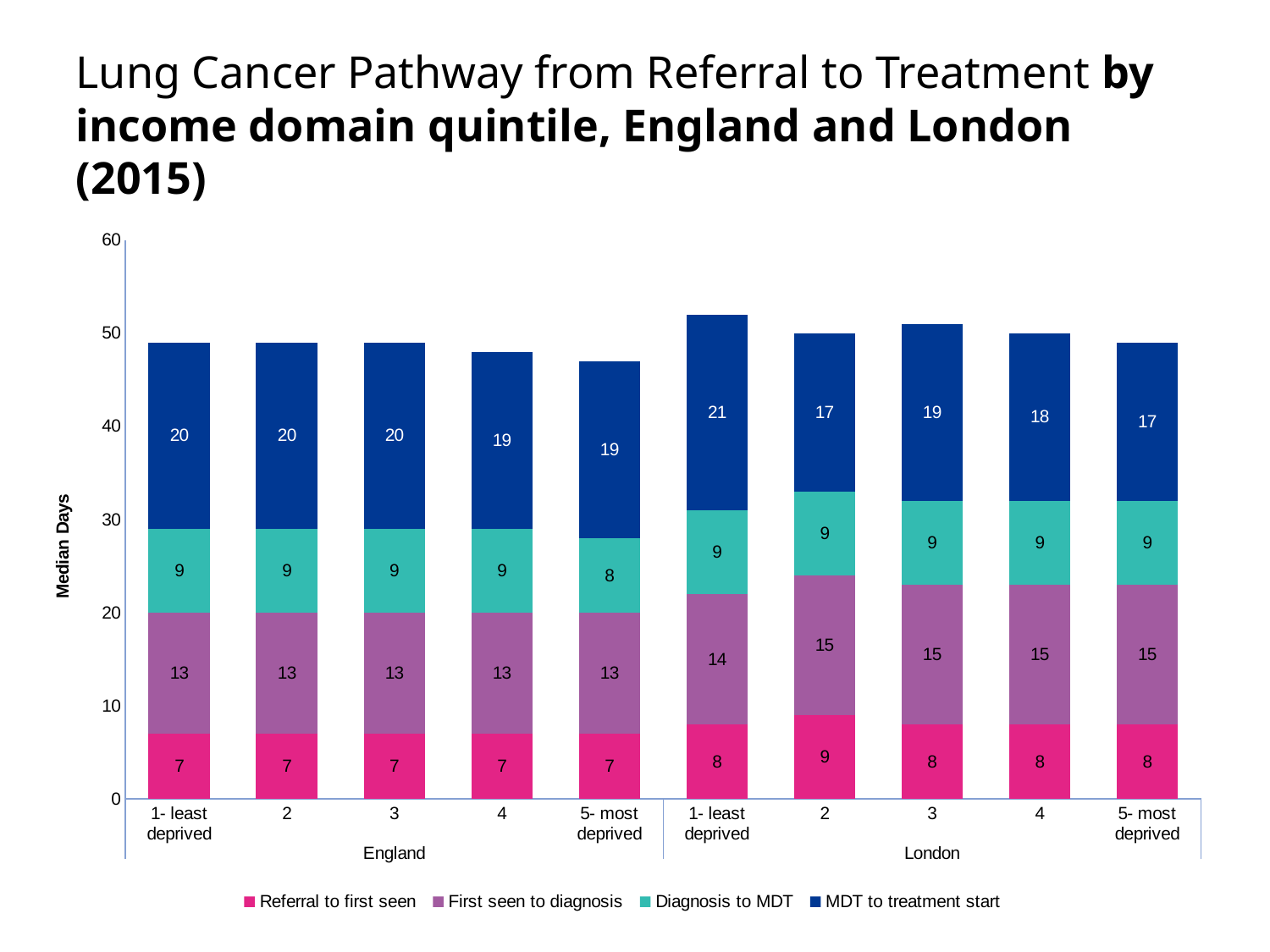
Which is larger: First seen to diagnosis for quintile 4 in England or for quintile 4 in London? Quintile 4 in London What is the total median days for the 1- least deprived quintile in London, summing all four stages? 52 Which bar has the lowest value for Diagnosis to MDT? 5- most deprived, England What is the median number of days from First seen to diagnosis for quintile 3 in England? 13 What is the difference in MDT to treatment start days between the 1- least deprived quintile in London and the 5- most deprived quintile in London? 4 What is the median number of days from Referral to first seen for quintile 2 in London? 9 Which bar has the highest value for MDT to treatment start? 1- least deprived, London What kind of chart is shown on the slide? Stacked bar chart What is the total median days for the 5- most deprived quintile in England, summing all four stages? 47 How many bars are plotted in the chart? 10 What is the median number of days from MDT to treatment start for the 1- least deprived quintile in London? 21 How many series does the legend list? 4